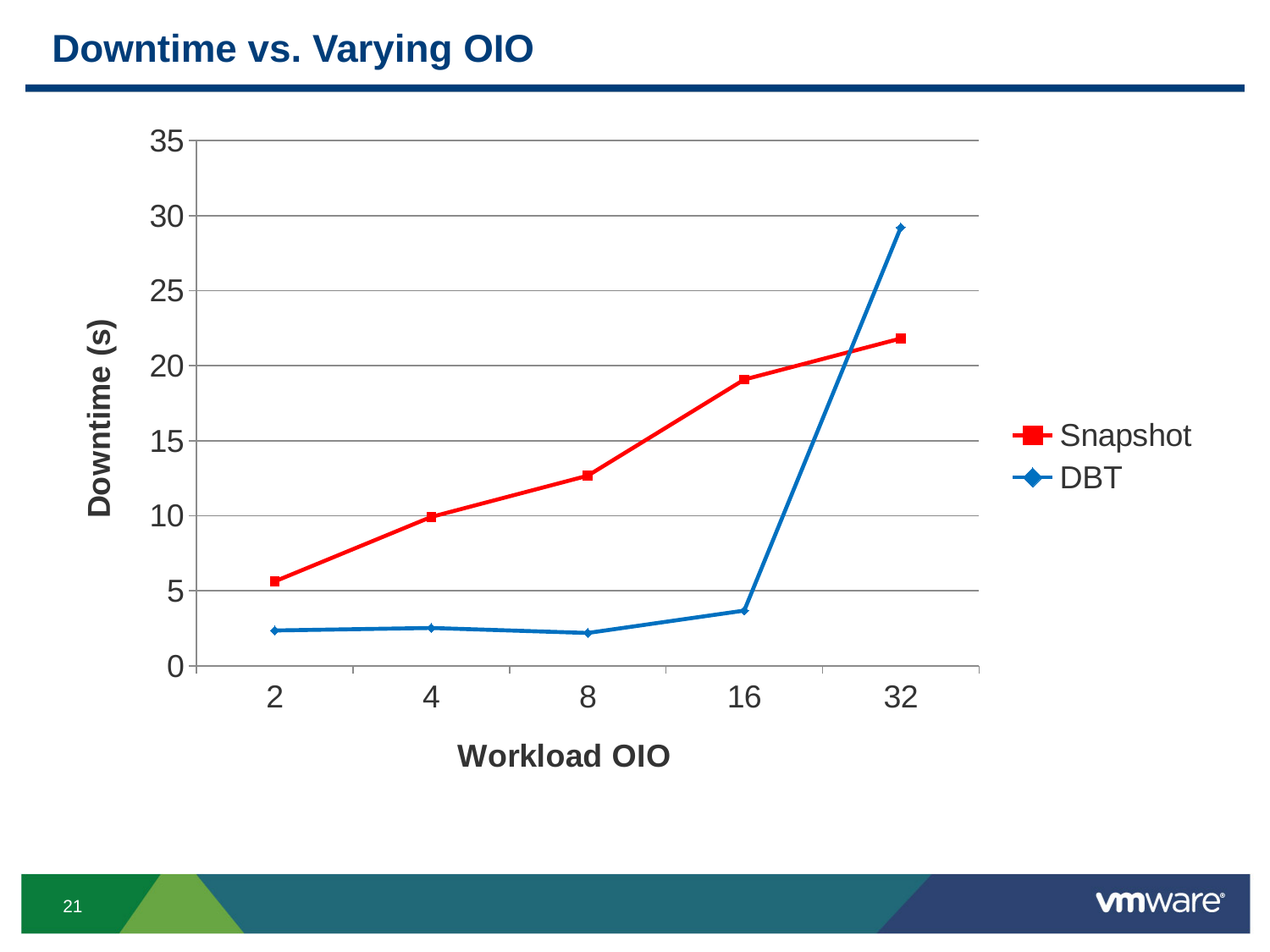
At which Workload OIO is the DBT downtime highest? 32 What is the label of the y axis? Downtime (s) At which Workload OIO is the Snapshot downtime lowest? 2 Is the Snapshot downtime at Workload OIO 8 greater or less than 10? greater Does the Snapshot downtime rise or fall as Workload OIO increases from 2 to 32? rise At Workload OIO 16, which series has the higher downtime, Snapshot or DBT? Snapshot Is the DBT downtime at Workload OIO 32 greater or less than 25? greater At which Workload OIO is the Snapshot downtime highest? 32 How many Workload OIO values are plotted along the x axis? 5 How many series does the legend list? 2 At Workload OIO 32, which series has the higher downtime, Snapshot or DBT? DBT What kind of chart is shown on the slide? line chart